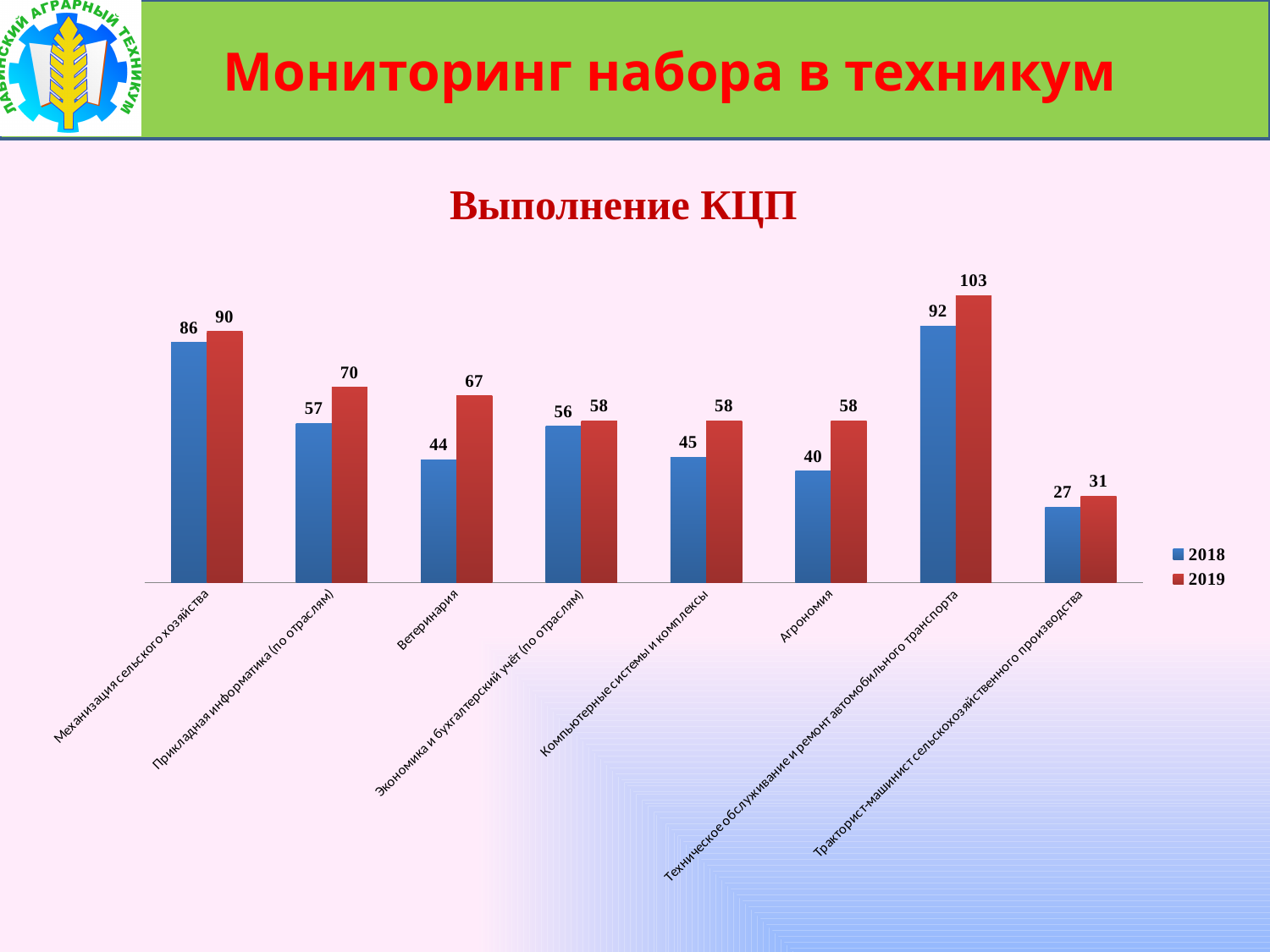
What is the 2018 value for Агрономия? 40 Which category has the highest 2019 value? Техническое обслуживание и ремонт автомобильного транспорта What is the 2019 value for Ветеринария? 67 What is the difference between the 2019 and 2018 values for Прикладная информатика (по отраслям)? 13 How many series does the legend list? 2 What is the title of the chart? Выполнение КЦП What is the difference between the 2019 and 2018 values for Агрономия? 18 Which category has the lowest 2018 value? Тракторист-машинист сельскохозяйственного производства What is the 2018 value for Тракторист-машинист сельскохозяйственного производства? 27 Which is larger: the 2018 value for Механизация сельского хозяйства or the 2019 value for Прикладная информатика (по отраслям)? 2018 value for Механизация сельского хозяйства How many categories are shown on the x axis? 8 What kind of chart is shown on the slide? Bar chart